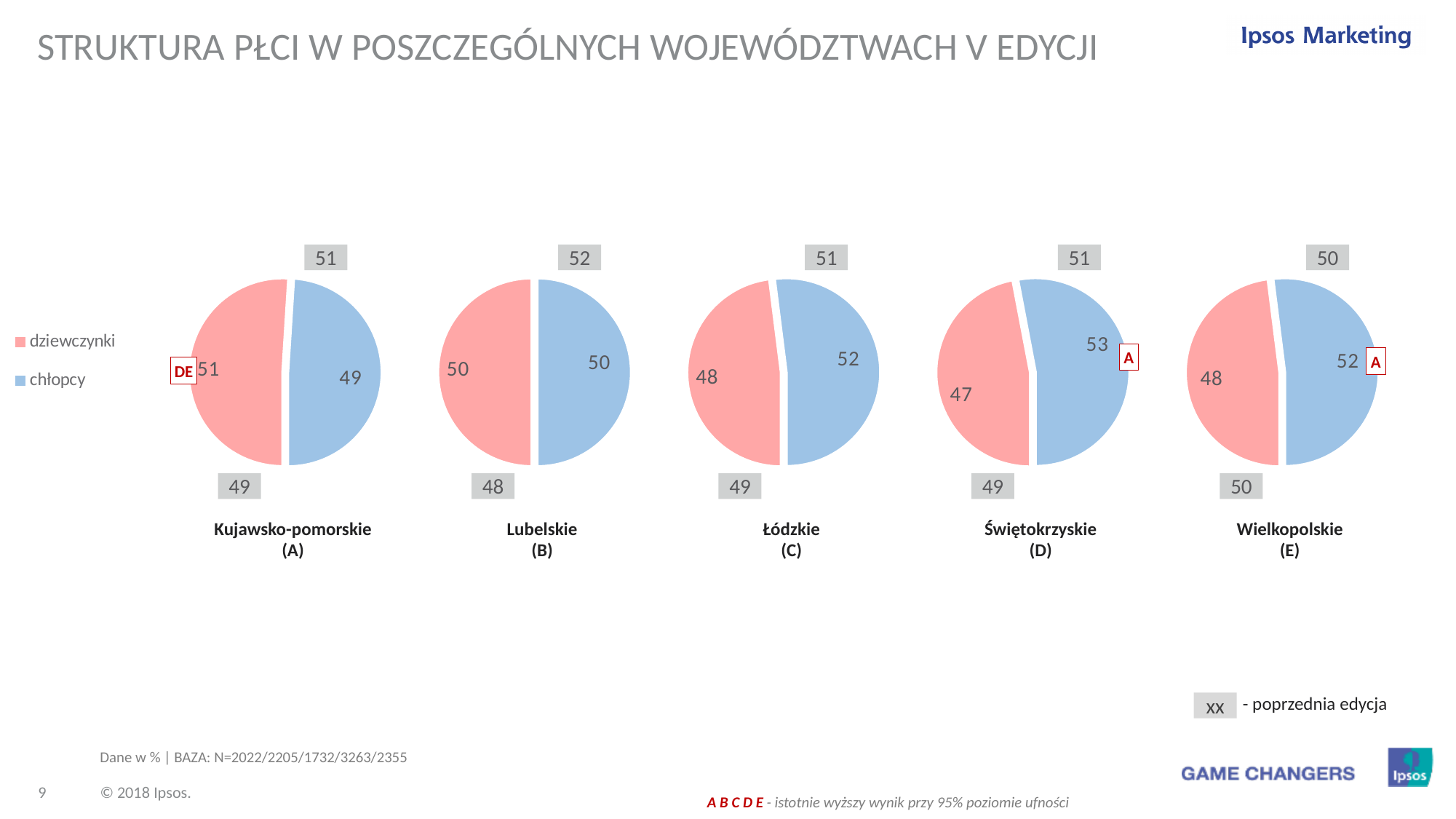
What type of chart is used for Lubelskie (B)? pie chart In the Świętokrzyskie (D) pie chart, what is the value for chłopcy? 53 In the Wielkopolskie (E) pie chart, what is the value for chłopcy? 52 How many pie charts are shown on the slide? 5 In the Świętokrzyskie (D) pie chart, what is the difference between the chłopcy and dziewczynki values? 6 How many series does the legend list? 2 In the Kujawsko-pomorskie (A) pie chart, what is the value for dziewczynki? 51 In the Łódzkie (C) pie chart, what is the difference between the chłopcy and dziewczynki values? 4 In the Kujawsko-pomorskie (A) pie chart, which slice is larger, dziewczynki or chłopcy? dziewczynki In the Łódzkie (C) pie chart, what is the value for dziewczynki? 48 In the Świętokrzyskie (D) pie chart, which slice is larger, dziewczynki or chłopcy? chłopcy In the Lubelskie (B) pie chart, what is the value for chłopcy? 50